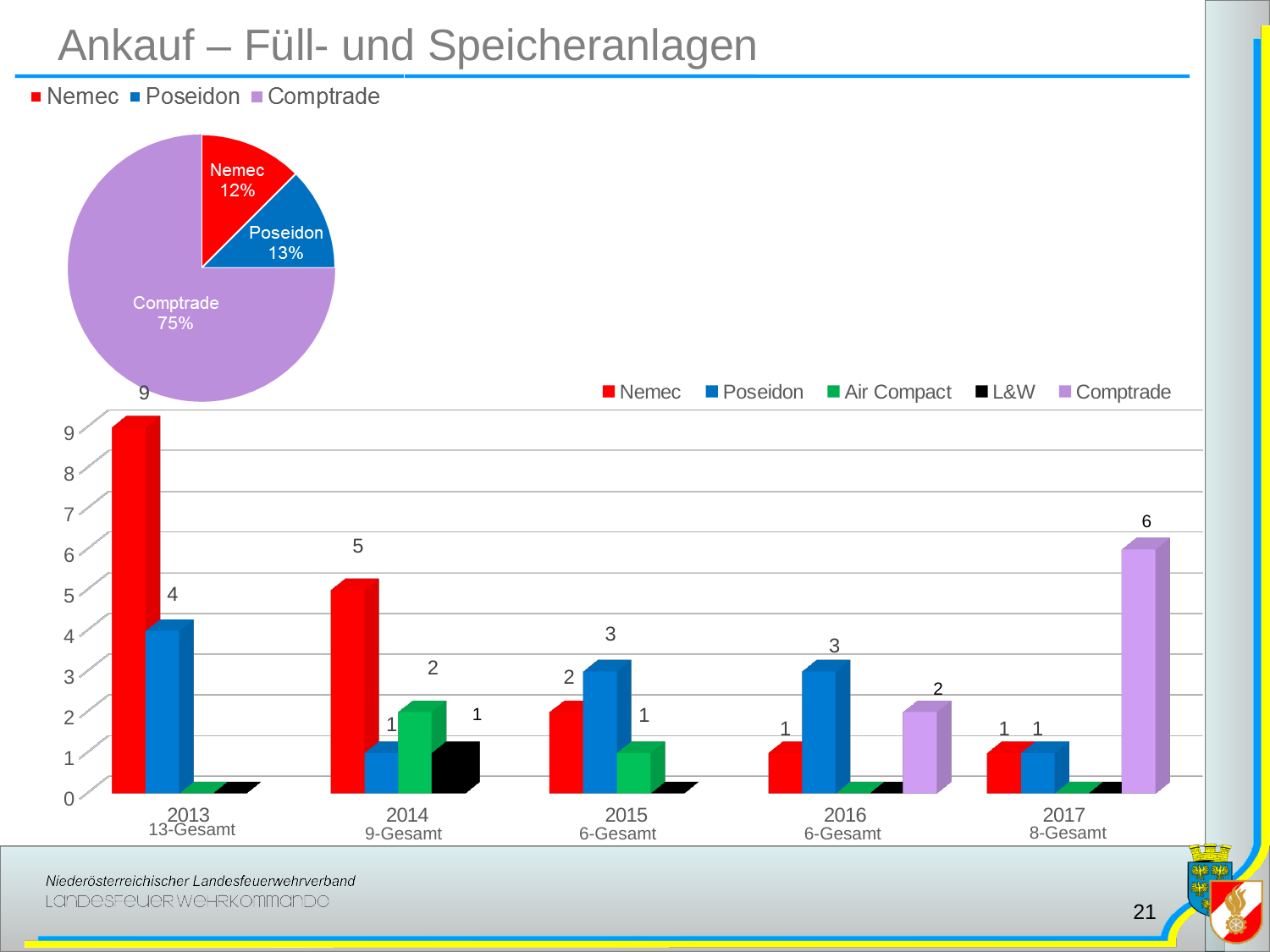
In the pie chart, what share does Comptrade have? 75% In the bar chart, what is the value for Comptrade in 2017? 6 How many series does the legend of the pie chart list? 3 In the pie chart, which slice is the largest? Comptrade How many years are shown on the x axis of the bar chart? 5 In the bar chart, what is the value for Nemec in 2013? 9 In the bar chart, which is larger in 2015, Nemec or Poseidon? Poseidon How many series does the legend of the bar chart list? 5 In the bar chart, what is the difference between Nemec and Poseidon in 2013? 5 In the bar chart, what is the value for Poseidon in 2016? 3 In the pie chart, what share does Nemec have? 12% What kind of chart is the lower chart on the slide? Bar chart